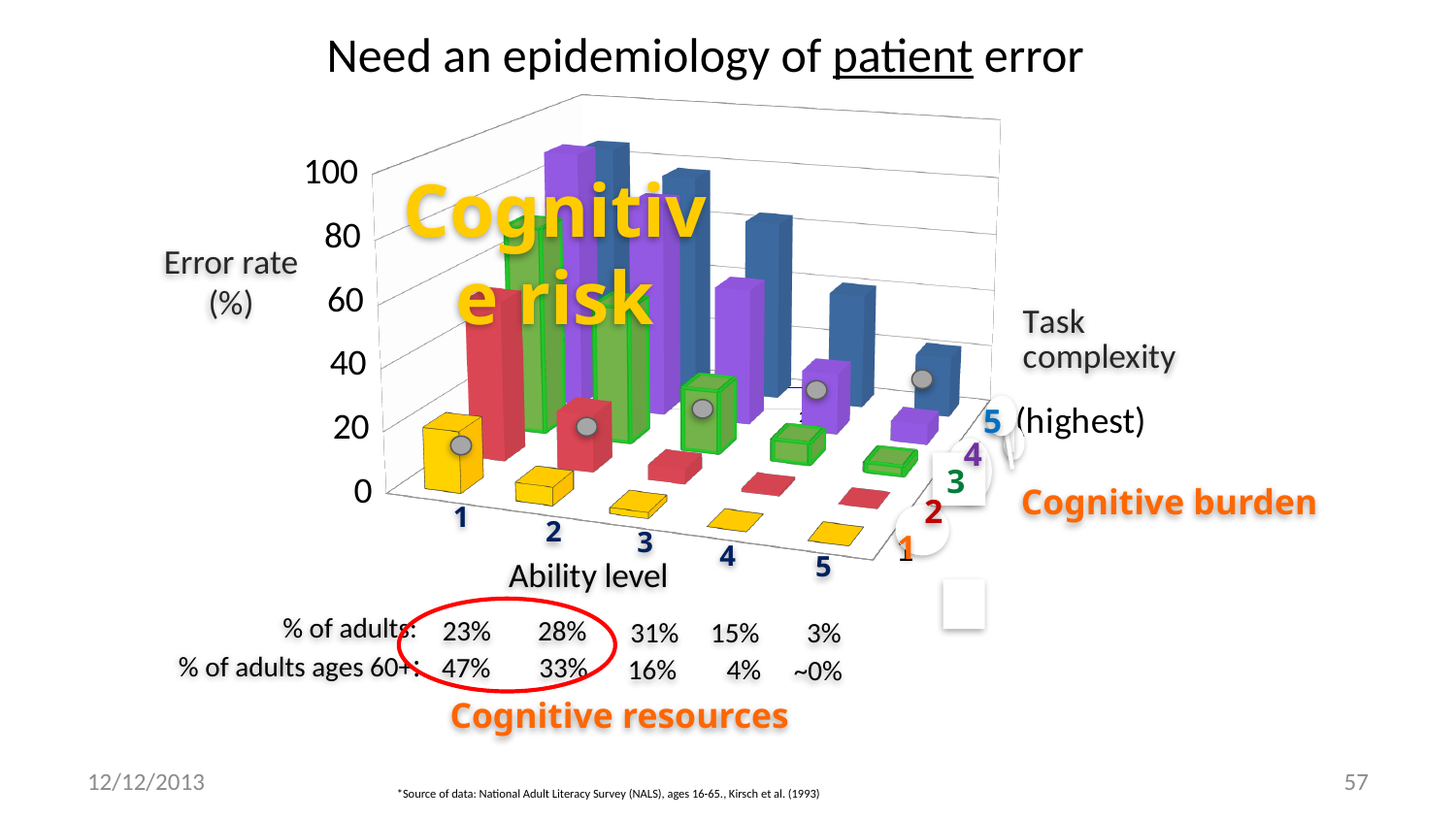
What is the label of the horizontal axis of the chart? Ability level What percentage of adults is listed under ability level 3? 31% What is the label of the vertical axis of the chart? Error rate (%) What percentage of adults ages 60+ is listed under ability level 1? 47% Is the error rate for ability level 5 at task complexity 1 greater or less than 20? less How many ability levels are shown along the x axis of the chart? 5 Which ability level has the highest error rate at task complexity 5? 1 Is the error rate for ability level 1 at task complexity 5 greater or less than 60? greater As ability level increases from 1 to 5, does the error rate rise or fall? fall What is the highest value shown on the error rate axis? 100 How many task complexity levels are shown in the chart? 5 What kind of chart is shown on the slide? bar chart